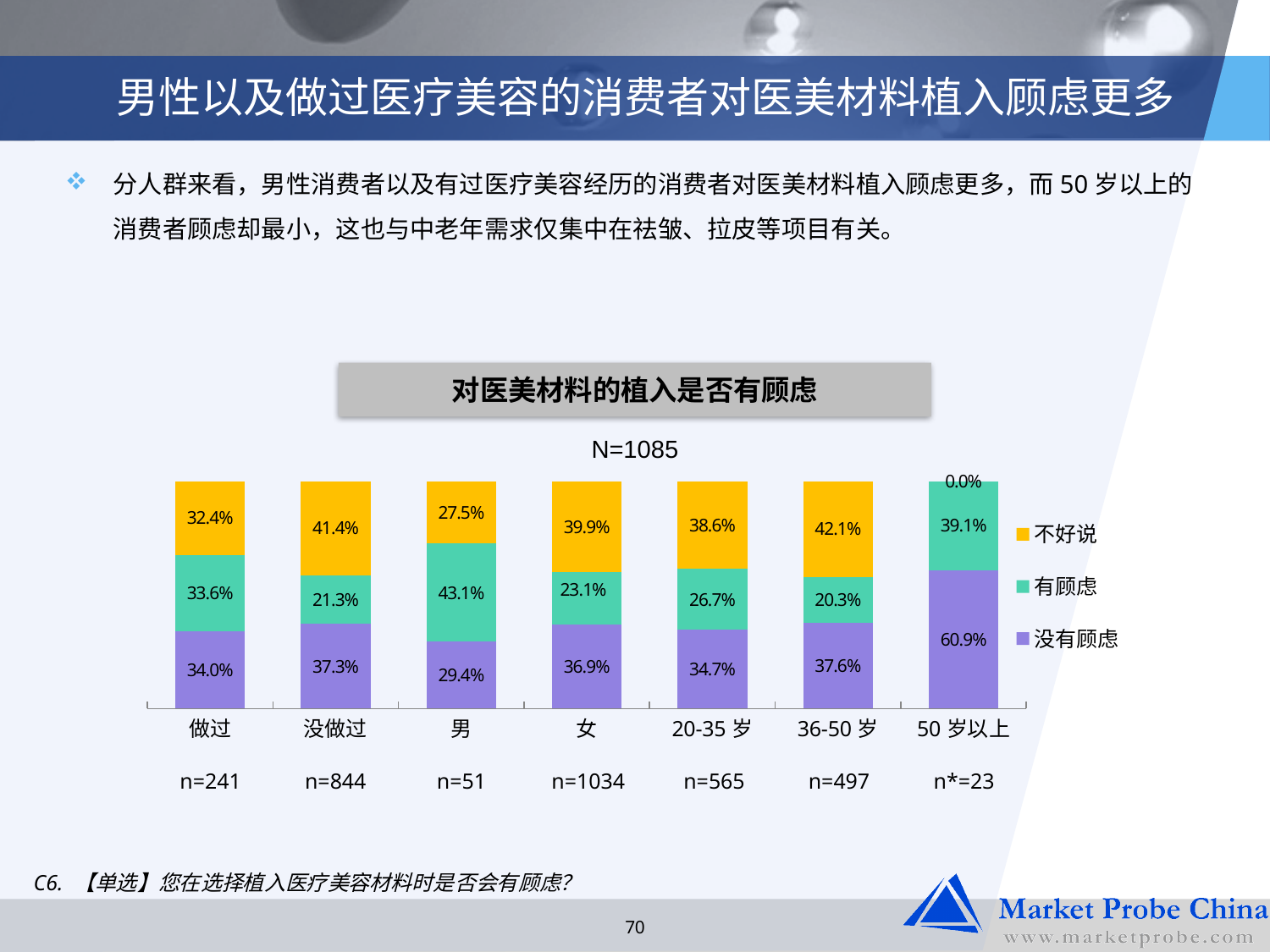
What is the value of 有顾虑 for the 男 category? 43.1% What is the difference between the 有顾虑 values for 做过 and 没做过? 12.3% What kind of chart is shown on the slide? stacked bar chart What is the value of 不好说 for the 36-50 岁 category? 42.1% Which category has the lowest value for 不好说? 50 岁以上 How many series does the legend list? 3 What is the title of the chart? 对医美材料的植入是否有顾虑 Which is larger, the 有顾虑 value for 男 or for 女? 男 What is the value of 没有顾虑 for the 50 岁以上 category? 60.9% What is the sample size (n) shown for the 女 category? n=1034 How many categories are shown along the x axis? 7 Which category has the highest value for 没有顾虑? 50 岁以上